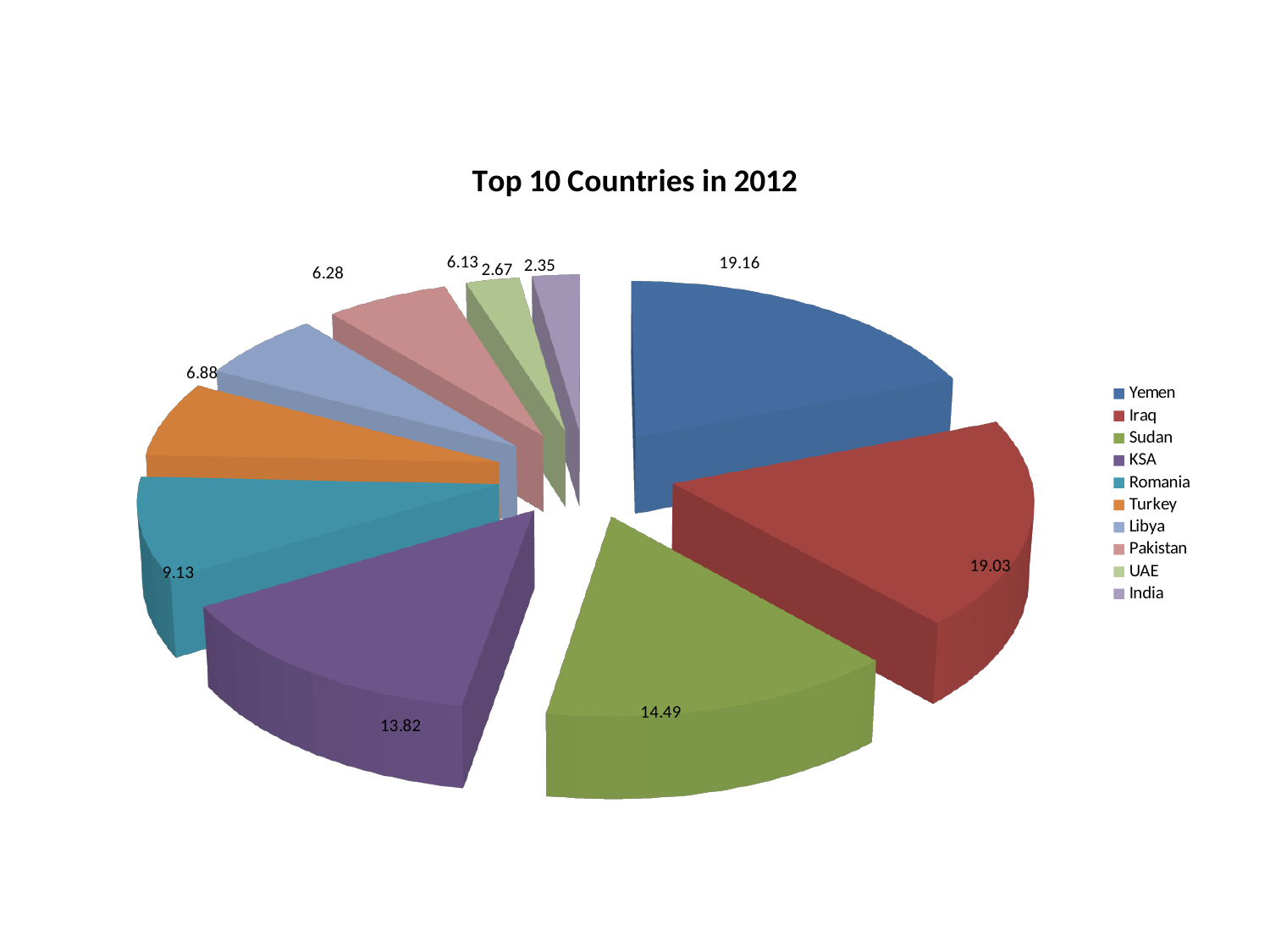
Which country has the largest slice? Yemen What is the title of the chart? Top 10 Countries in 2012 What is the value for Romania? 9.13 What is the difference between the values for Romania and Turkey? 2.25 Which country has the smallest slice? India What type of chart is shown on the slide? Pie chart How many countries are shown in the pie chart? 10 Which is larger, the value for Turkey or the value for Pakistan? Turkey What is the value for Libya? 6.28 What is the value for Sudan? 14.49 What is the value for Yemen? 19.16 What is the difference between the values for Sudan and KSA? 0.67